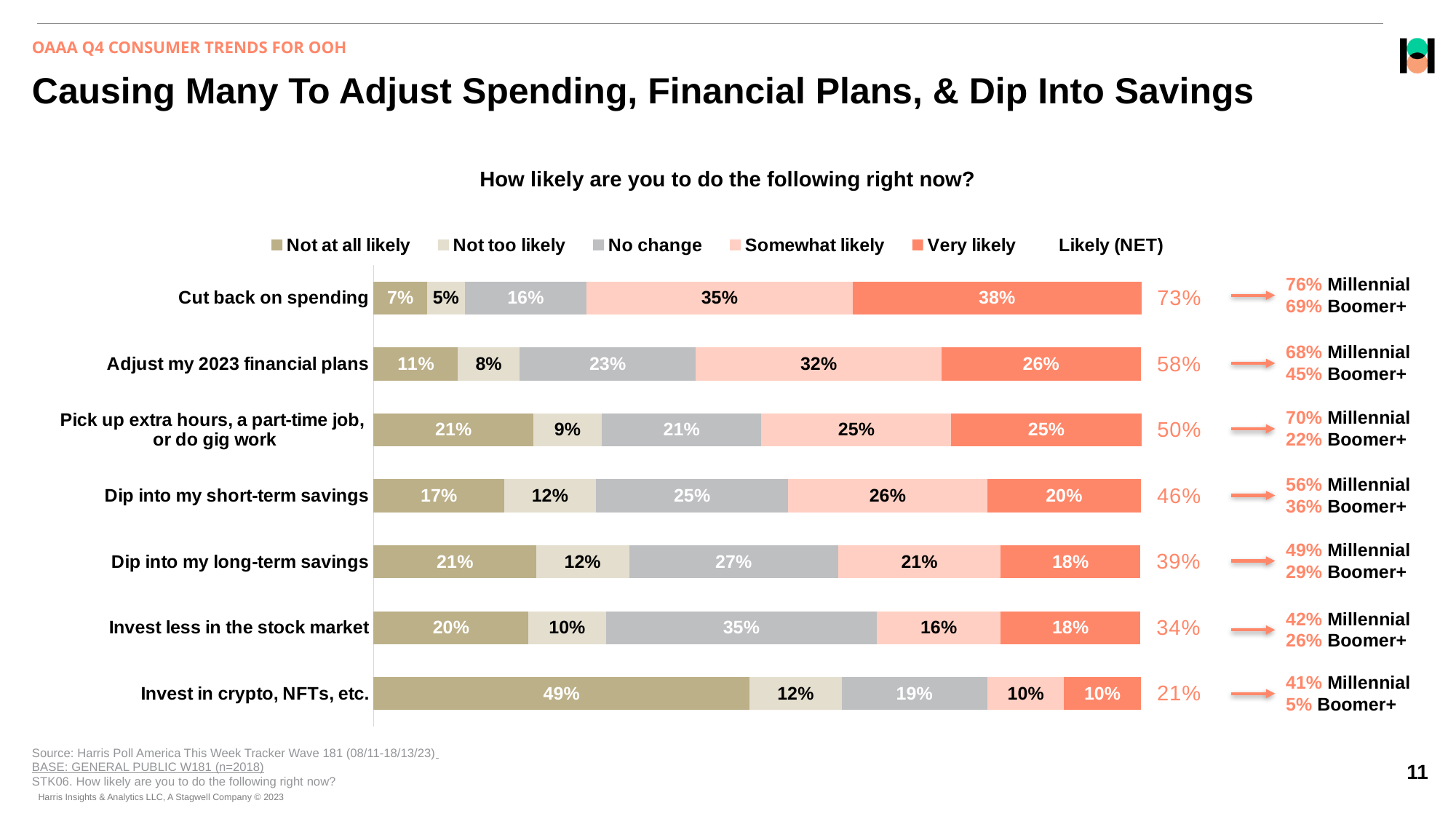
What percentage of respondents are 'Very likely' to cut back on spending? 38% What kind of chart is shown on the slide? Stacked bar chart What question is the chart titled with? How likely are you to do the following right now? Which item has the lowest Likely (NET) value? Invest in crypto, NFTs, etc. What is the difference between the 'Very likely' values for 'Cut back on spending' and 'Adjust my 2023 financial plans'? 12% What is the Likely (NET) value for 'Dip into my short-term savings'? 46% Which is larger: the 'Somewhat likely' value for 'Dip into my short-term savings' or for 'Dip into my long-term savings'? Dip into my short-term savings What is the Millennial Likely (NET) value shown for 'Pick up extra hours, a part-time job, or do gig work'? 70% What is the 'Not at all likely' value for 'Invest in crypto, NFTs, etc.'? 49% What is the 'No change' value for 'Invest less in the stock market'? 35% Which item has the highest Likely (NET) value? Cut back on spending How many items (categories) are shown in the chart? 7